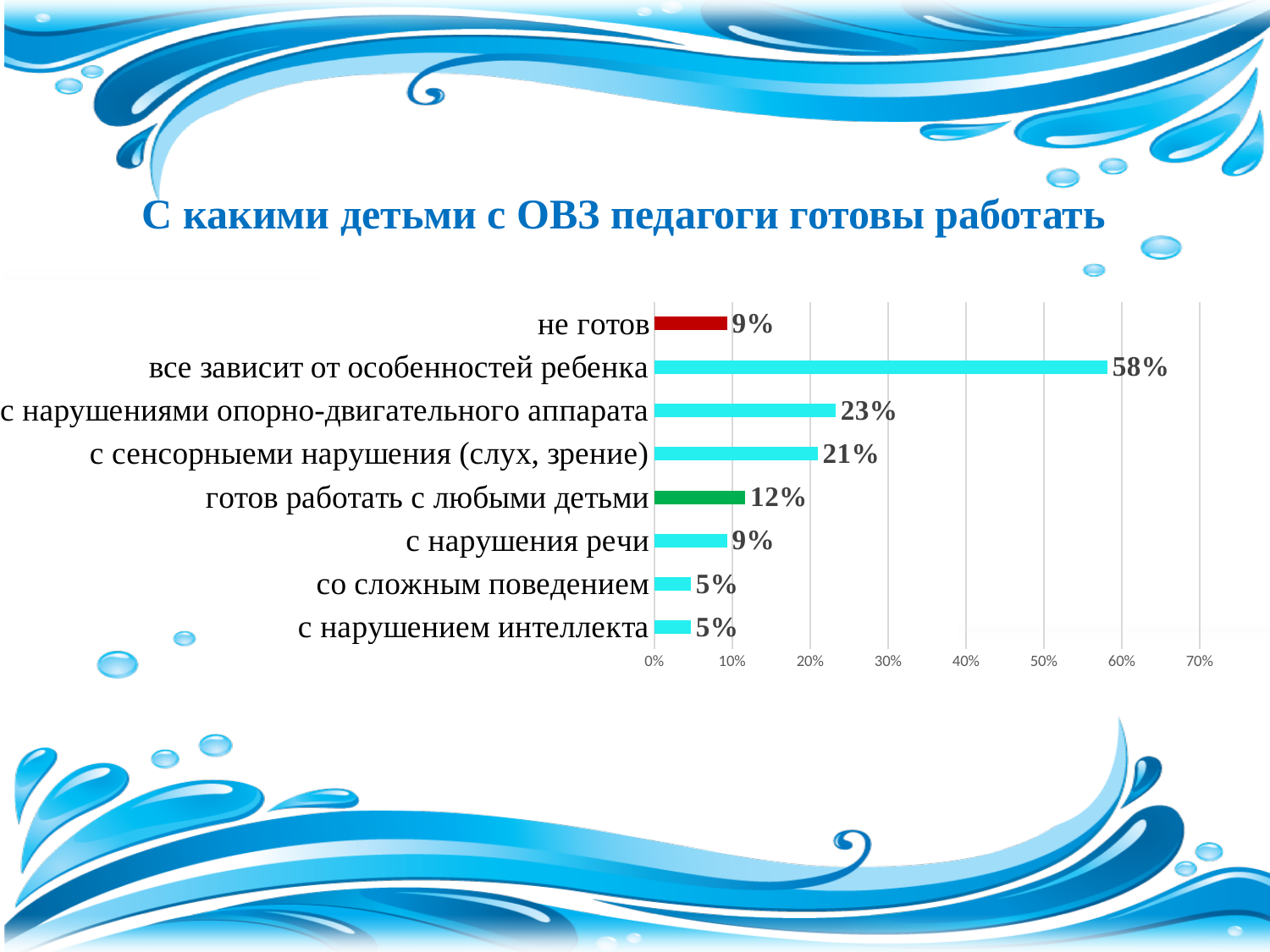
What is the value for "с нарушениями опорно-двигательного аппарата"? 23% Which category has the highest value? все зависит от особенностей ребенка What is the value for "все зависит от особенностей ребенка"? 58% Is the value for "все зависит от особенностей ребенка" greater or less than 50%? greater What is the value for "не готов"? 9% Which is larger: the value for "готов работать с любыми детьми" or the value for "с нарушения речи"? готов работать с любыми детьми What colour is the bar for "не готов"? red What is the difference between the values for "с нарушениями опорно-двигательного аппарата" and "с сенсорныеми нарушения (слух, зрение)"? 2% What is the value for "готов работать с любыми детьми"? 12% How many categories are shown in the chart? 8 What is the title of the chart? С какими детьми с ОВЗ педагоги готовы работать What type of chart is shown on the slide? bar chart